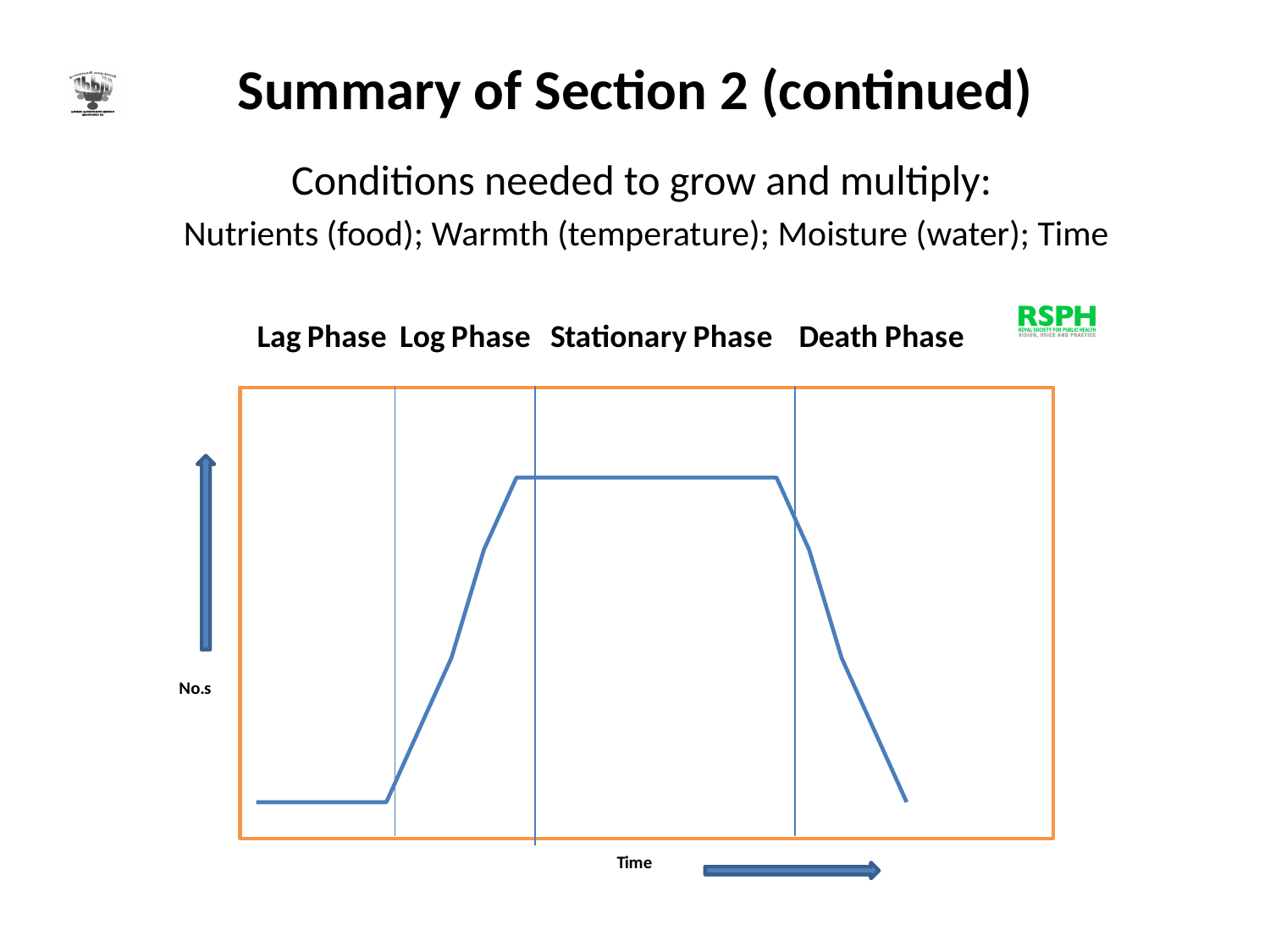
In which phase does the line reach its highest level? Stationary Phase Which phase has the lower line level, the Lag Phase or the Stationary Phase? Lag Phase What kind of chart is shown on the slide? line chart During the Stationary Phase, does the line rise, fall, or stay flat? stay flat Is the line higher at the end of the Log Phase or at the start of the Log Phase? at the end of the Log Phase What is the label on the horizontal axis of the chart? Time How many phases are labelled above the chart? 4 What is the label on the vertical axis of the chart? No.s During the Death Phase, does the line rise or fall along the x axis? fall Which phase comes first along the x axis? Lag Phase During the Log Phase, does the line rise or fall along the x axis? rise